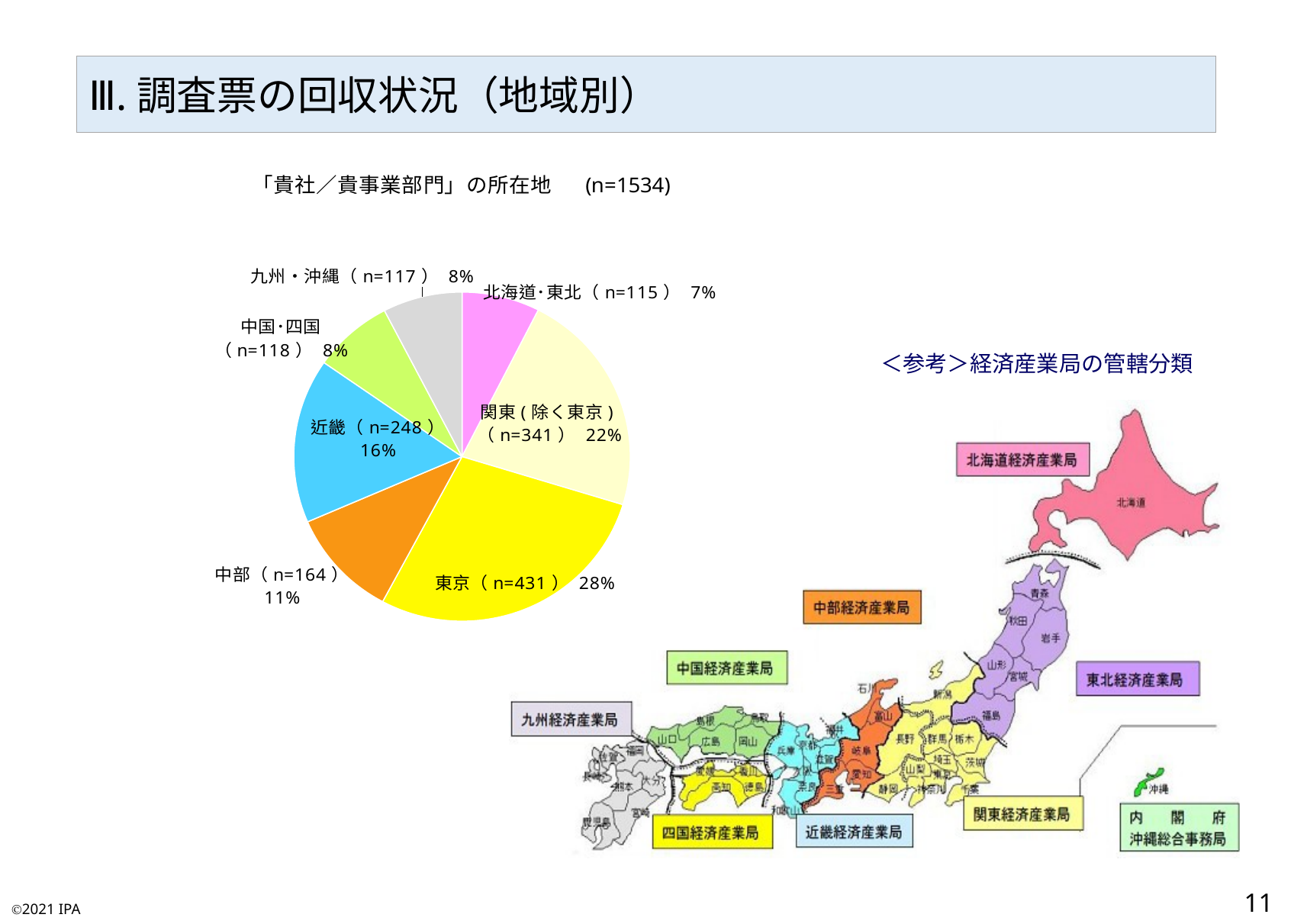
Which region has the smallest share in the pie chart? 北海道・東北 What kind of chart is shown on the slide? pie chart What is the n value for 関東(除く東京) in the pie chart? 341 How many slices does the pie chart have? 7 What is the n value for 近畿 in the pie chart? 248 What percentage share does 中国・四国 have in the pie chart? 8% What is the difference in n between 東京 and 関東(除く東京)? 90 What percentage share does 東京 have in the pie chart? 28% Which has a larger share, 近畿 or 中部? 近畿 What is the total n shown for the pie chart? 1534 Which region has the largest share in the pie chart? 東京 What is the title of the pie chart? 「貴社／貴事業部門」の所在地